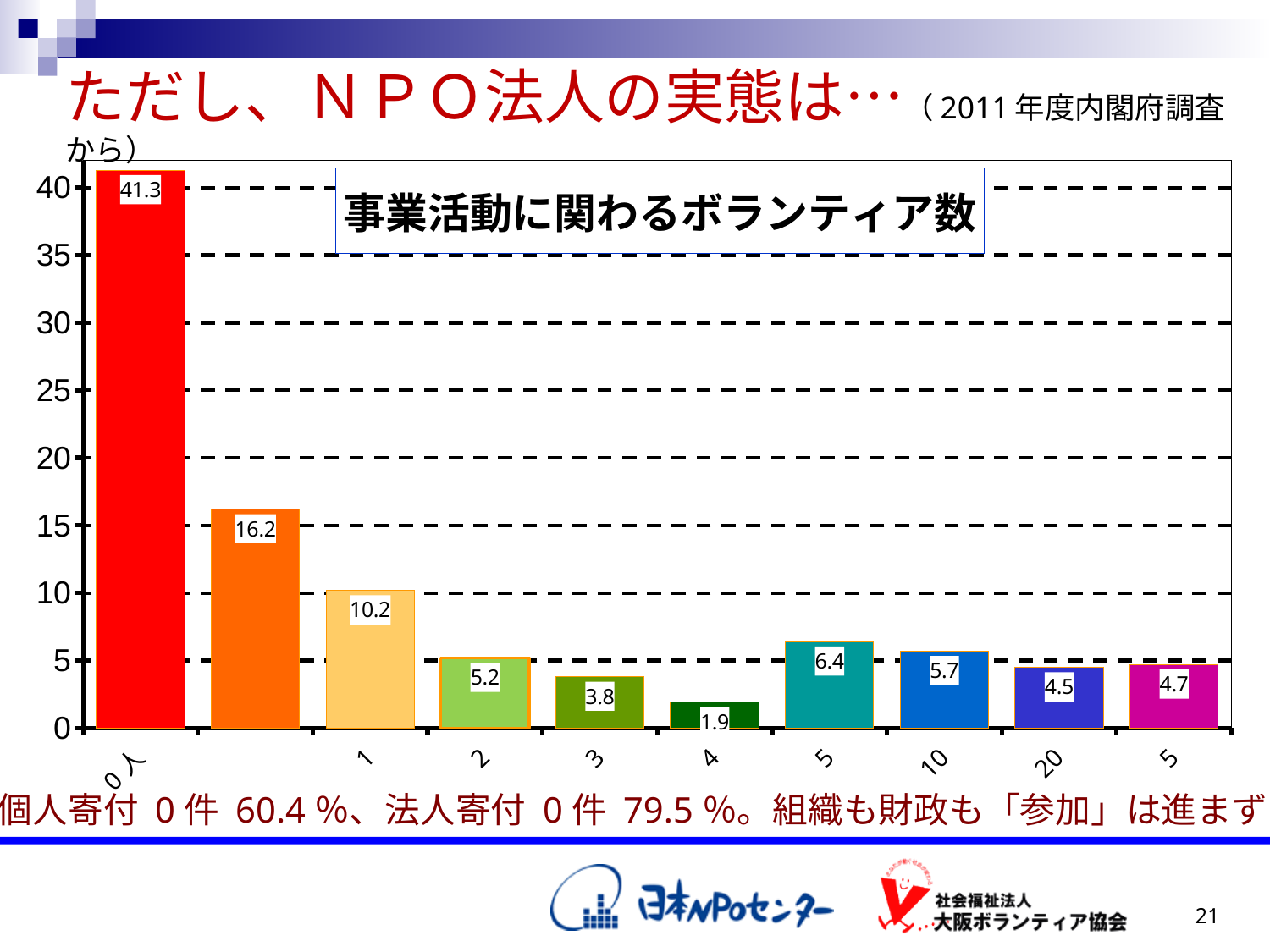
What is the value of the second (orange) bar? 16.2 What is the value of the third (light yellow) bar? 10.2 Which bar has the highest value? the first bar (0人), 41.3 What is the value of the first (red) bar, labelled 0人? 41.3 What type of chart is shown on the slide? bar chart What is the title shown in the box on the chart? 事業活動に関わるボランティア数 What is the difference between the first bar (41.3) and the second bar (16.2)? 25.1 Which bar has the lowest value? the sixth (dark green) bar, 1.9 Which is larger, the teal bar (6.4) or the blue bar (5.7)? the teal bar, 6.4 How many bars are plotted in the chart? 10 What is the value of the dark green (sixth) bar? 1.9 Is the value of the first bar greater or less than 40? greater